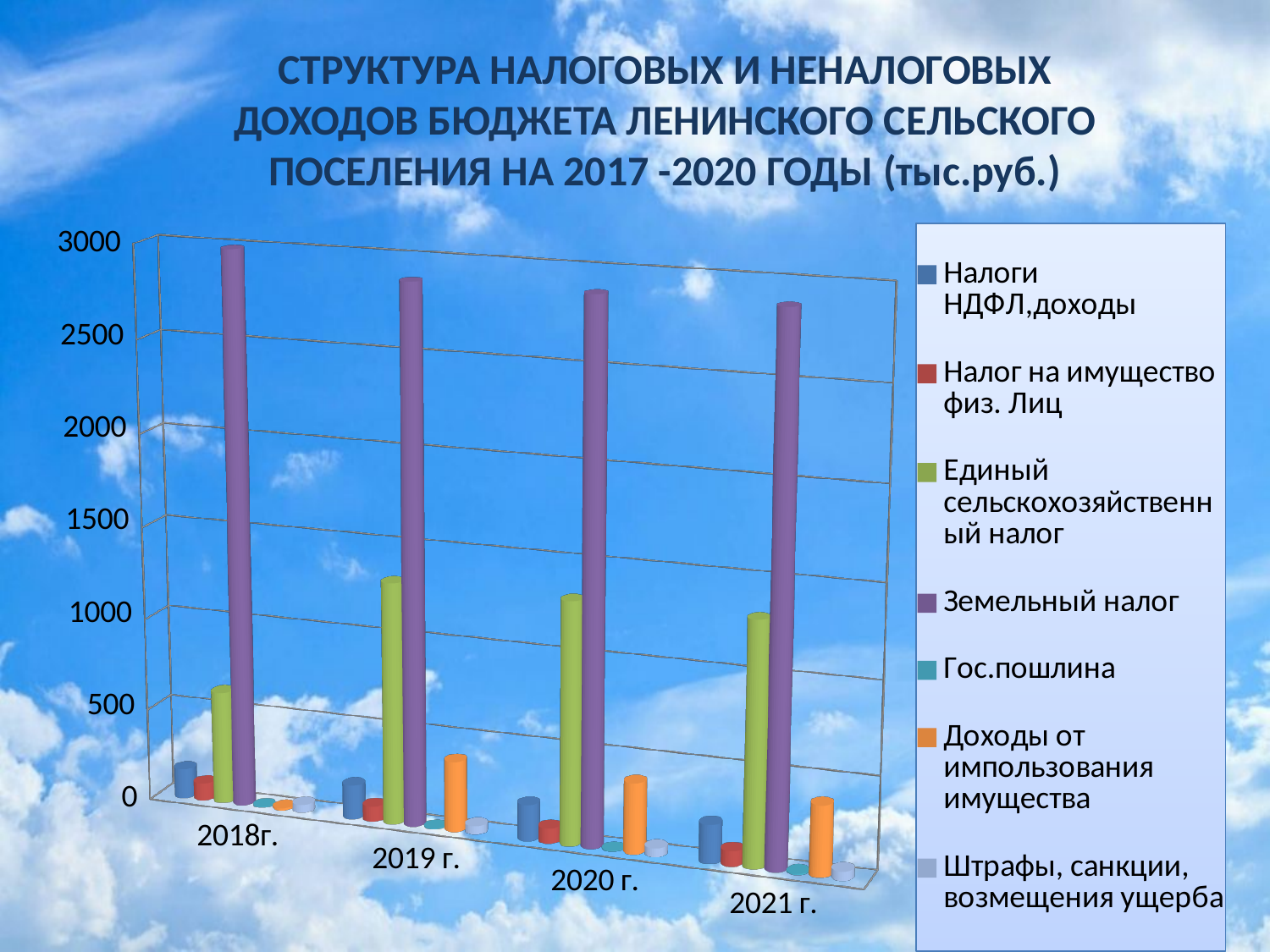
How many series does the chart legend list? 7 Which is larger in 2019 г.: Земельный налог or Единый сельскохозяйственный налог? Земельный налог How many years (categories) are shown on the x axis of the chart? 4 What kind of chart is shown on the slide? bar chart Is the value for Земельный налог in 2018г. greater or less than 2500? greater Does the value for Земельный налог rise or fall from 2018г. to 2021 г.? fall Which series has the highest value in 2018г.? Земельный налог What colour represents Земельный налог in the chart legend? purple In which year is the value for Земельный налог the highest? 2018г. Is the value for Единый сельскохозяйственный налог in 2018г. greater or less than 1000? less Is the value for Налоги НДФЛ,доходы in 2018г. greater or less than 500? less Which is larger for Единый сельскохозяйственный налог: the value in 2018г. or in 2019 г.? 2019 г.